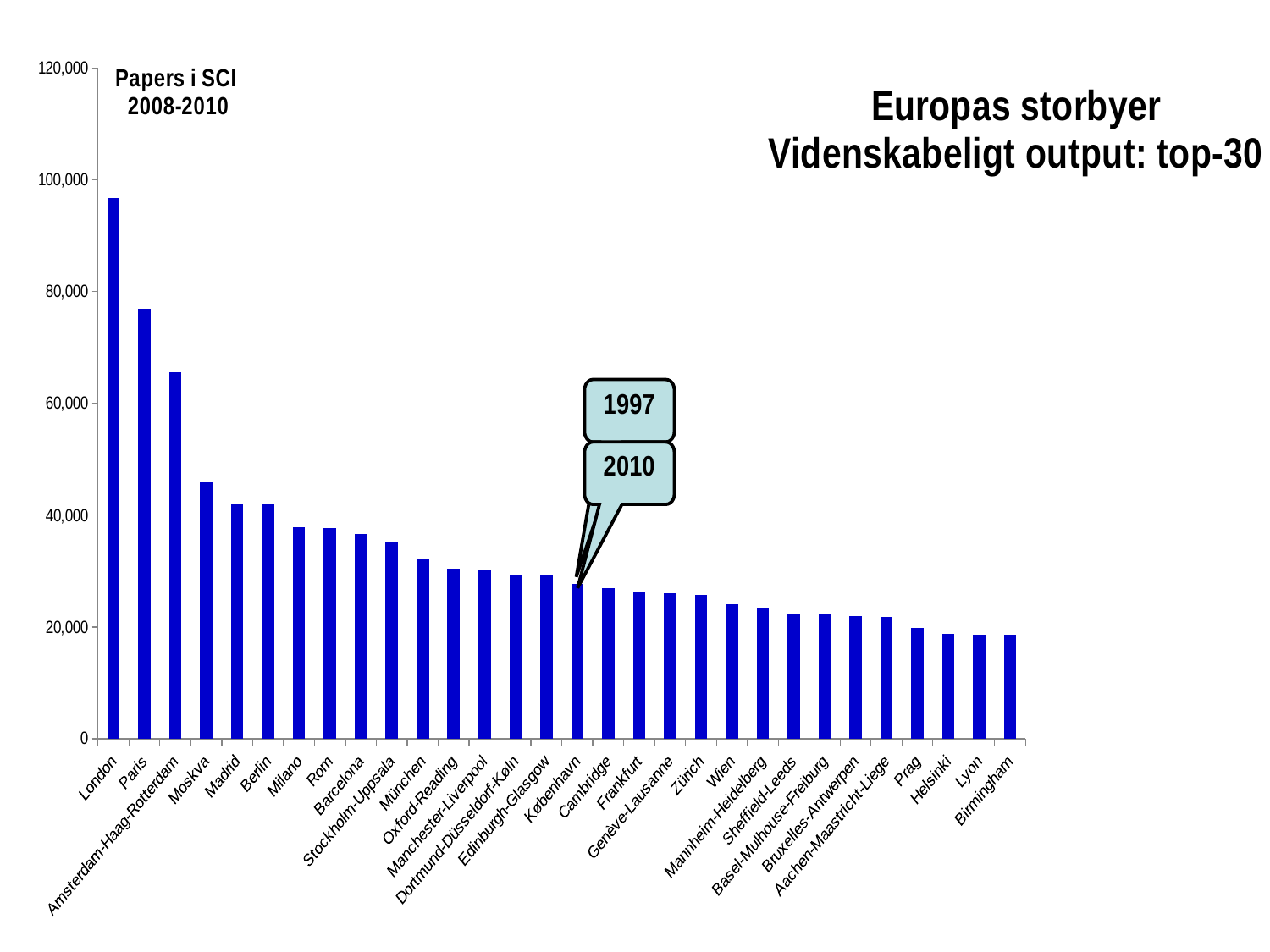
Is the value for Moskva greater or less than 40,000? greater Do the bar values rise or fall from left to right along the x axis? fall How many cities are shown on the x axis of the chart? 30 Which city has the highest number of papers in the chart? London Which has a larger value, Berlin or Wien? Berlin What kind of chart is shown on the slide? bar chart Is the value for Paris greater or less than 80,000? less Is the value for Amsterdam-Haag-Rotterdam greater or less than 60,000? greater What is the title printed inside the chart area? Papers i SCI 2008-2010 Which has a larger value, Paris or Moskva? Paris